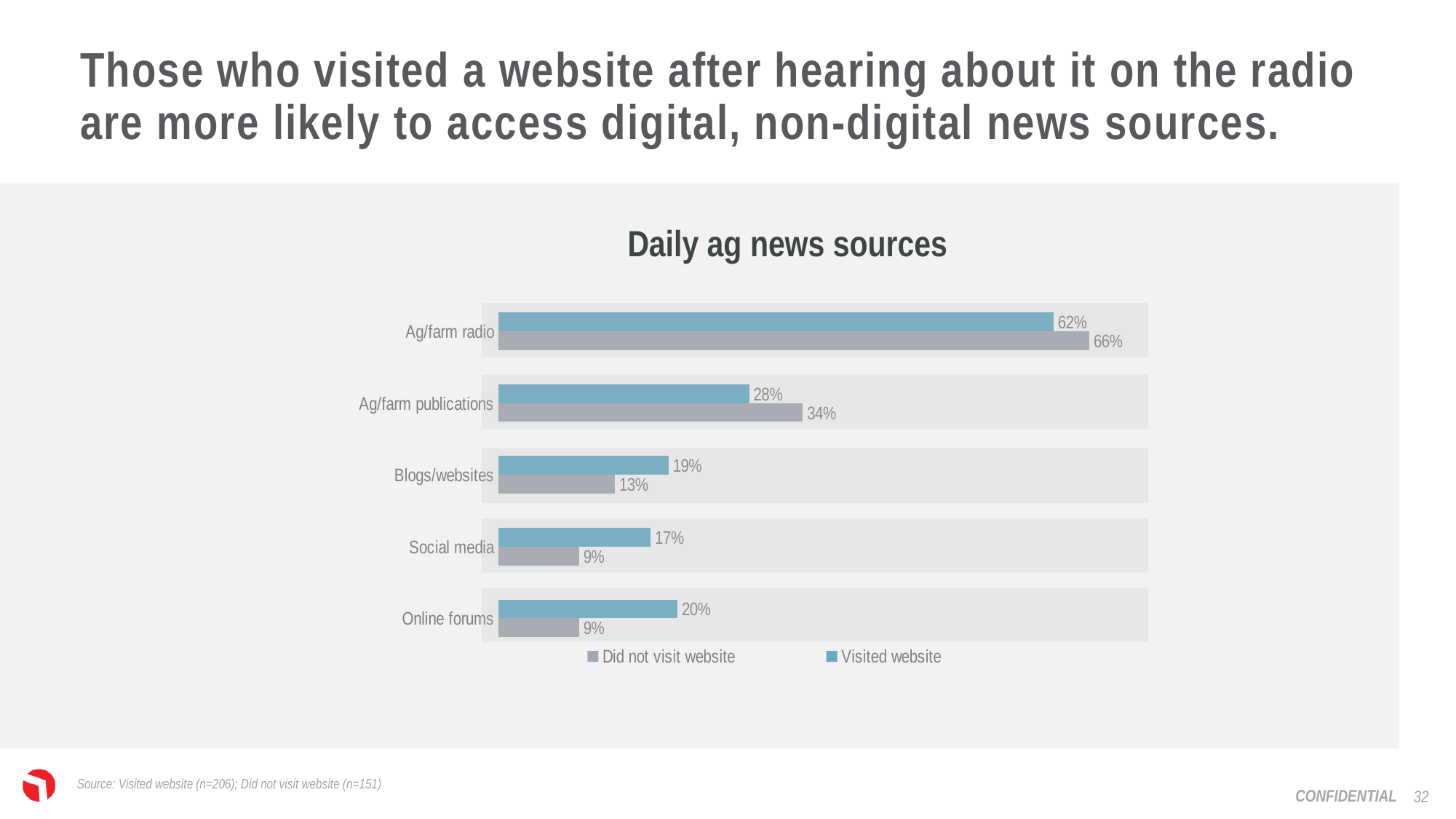
For Blogs/websites, which series has the larger value: Visited website or Did not visit website? Visited website How many categories are shown in the chart? 5 Which category has the highest value in the Did not visit website series? Ag/farm radio What is the value for Social media in the Visited website series? 17% What is the difference between the Visited website and Did not visit website values for Social media? 8% What kind of chart is shown on the slide? Bar chart What is the value for Ag/farm publications in the Did not visit website series? 34% What is the difference between the Did not visit website and Visited website values for Ag/farm radio? 4% Which category has the lowest value in the Visited website series? Social media What is the value for Online forums in the Did not visit website series? 9% How many series does the legend list? 2 What is the value for Ag/farm radio in the Visited website series? 62%